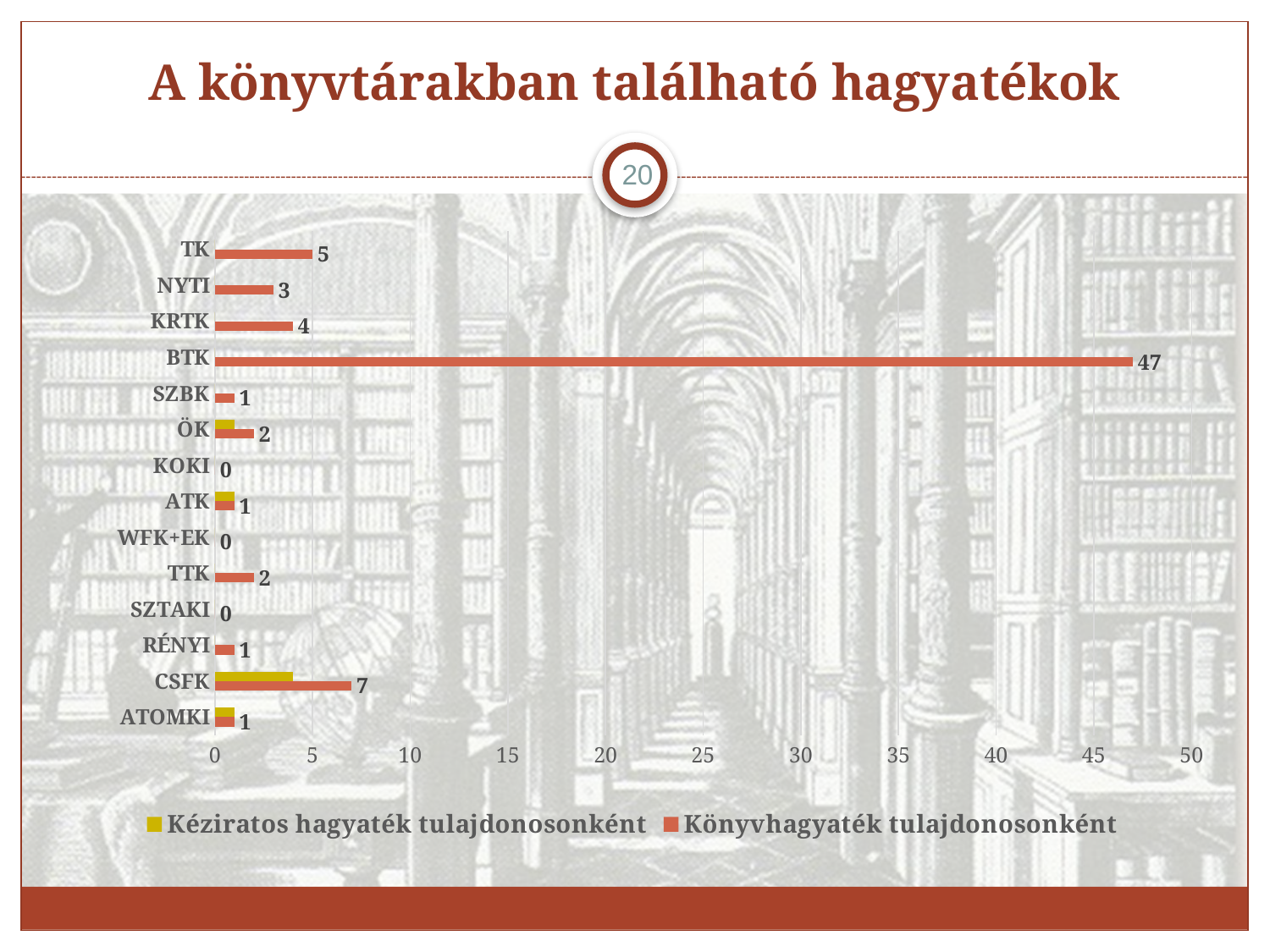
Is the Könyvhagyaték tulajdonosonként value for BTK greater or less than 45? greater Which has a larger Könyvhagyaték tulajdonosonként value, TK or NYTI? TK How many series does the legend list? 2 Which series is shown in yellow in the legend? Kéziratos hagyaték tulajdonosonként Which category has the highest value for Könyvhagyaték tulajdonosonként? BTK What is the value of Könyvhagyaték tulajdonosonként for BTK? 47 What kind of chart is shown on the slide? bar chart How many categories are shown on the chart? 14 What is the value of Könyvhagyaték tulajdonosonként for CSFK? 7 What is the value of Könyvhagyaték tulajdonosonként for KRTK? 4 What is the difference between the Könyvhagyaték tulajdonosonként values for BTK and CSFK? 40 What is the value of Könyvhagyaték tulajdonosonként for TK? 5